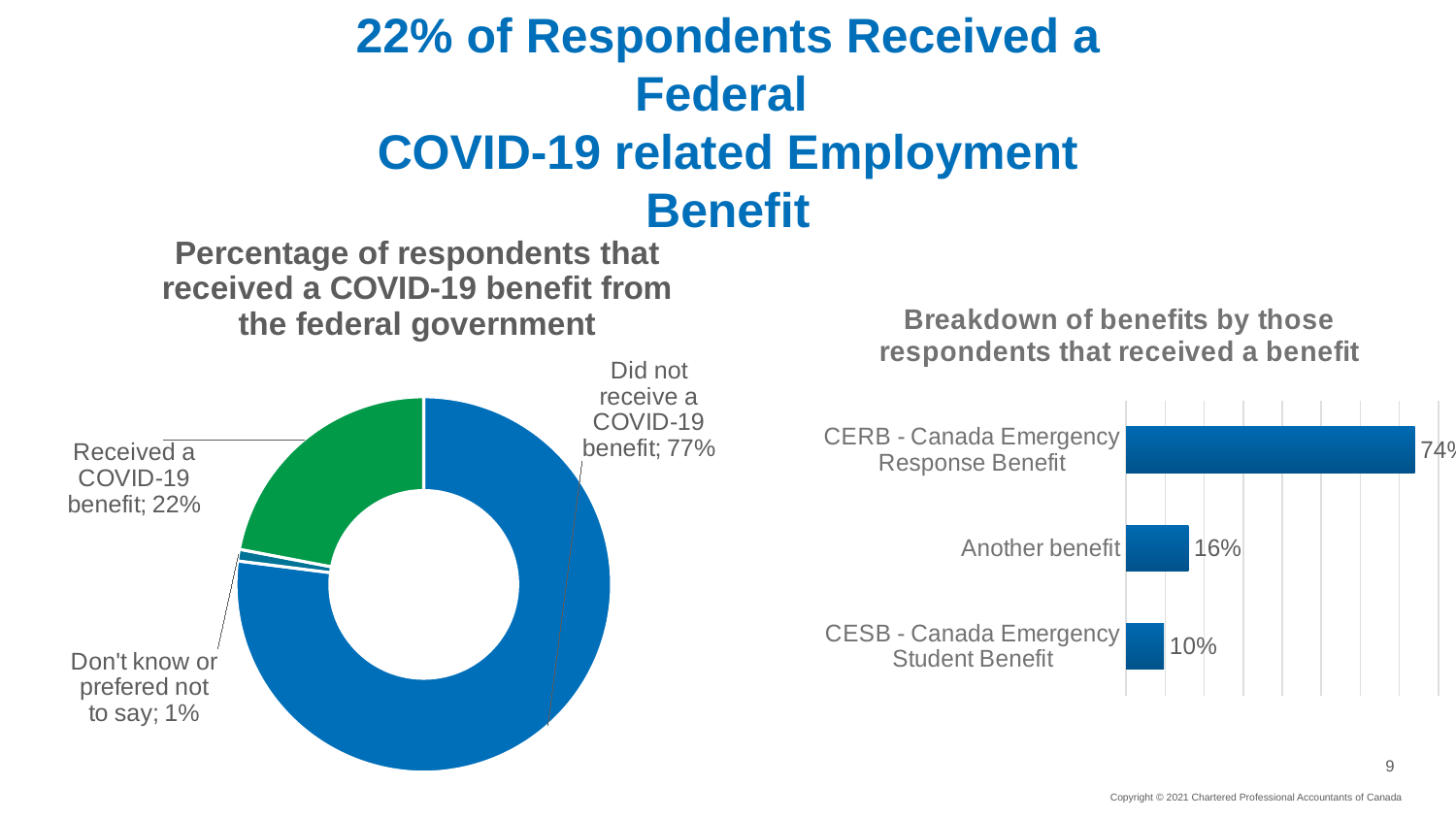
In the chart titled 'Breakdown of benefits by those respondents that received a benefit', what is the value for 'Another benefit'? 16% In the chart titled 'Percentage of respondents that received a COVID-19 benefit from the federal government', what percentage of respondents did not receive a COVID-19 benefit? 77% In the chart titled 'Percentage of respondents that received a COVID-19 benefit from the federal government', which category has the largest slice? Did not receive a COVID-19 benefit In the chart titled 'Breakdown of benefits by those respondents that received a benefit', which benefit has the lowest value? CESB - Canada Emergency Student Benefit In the chart titled 'Percentage of respondents that received a COVID-19 benefit from the federal government', what percentage of respondents received a COVID-19 benefit? 22% In the chart titled 'Breakdown of benefits by those respondents that received a benefit', which benefit has the highest value? CERB - Canada Emergency Response Benefit In the chart titled 'Breakdown of benefits by those respondents that received a benefit', what is the difference between 'Another benefit' and 'CESB - Canada Emergency Student Benefit'? 6% In the chart titled 'Percentage of respondents that received a COVID-19 benefit from the federal government', how many slices does the chart have? 3 What kind of chart is the one on the left of the slide? Pie (donut) chart In the chart titled 'Breakdown of benefits by those respondents that received a benefit', what is the value for 'CESB - Canada Emergency Student Benefit'? 10% What kind of chart is the one on the right of the slide? Bar chart In the chart titled 'Percentage of respondents that received a COVID-19 benefit from the federal government', what share is labelled 'Don't know or prefered not to say'? 1%